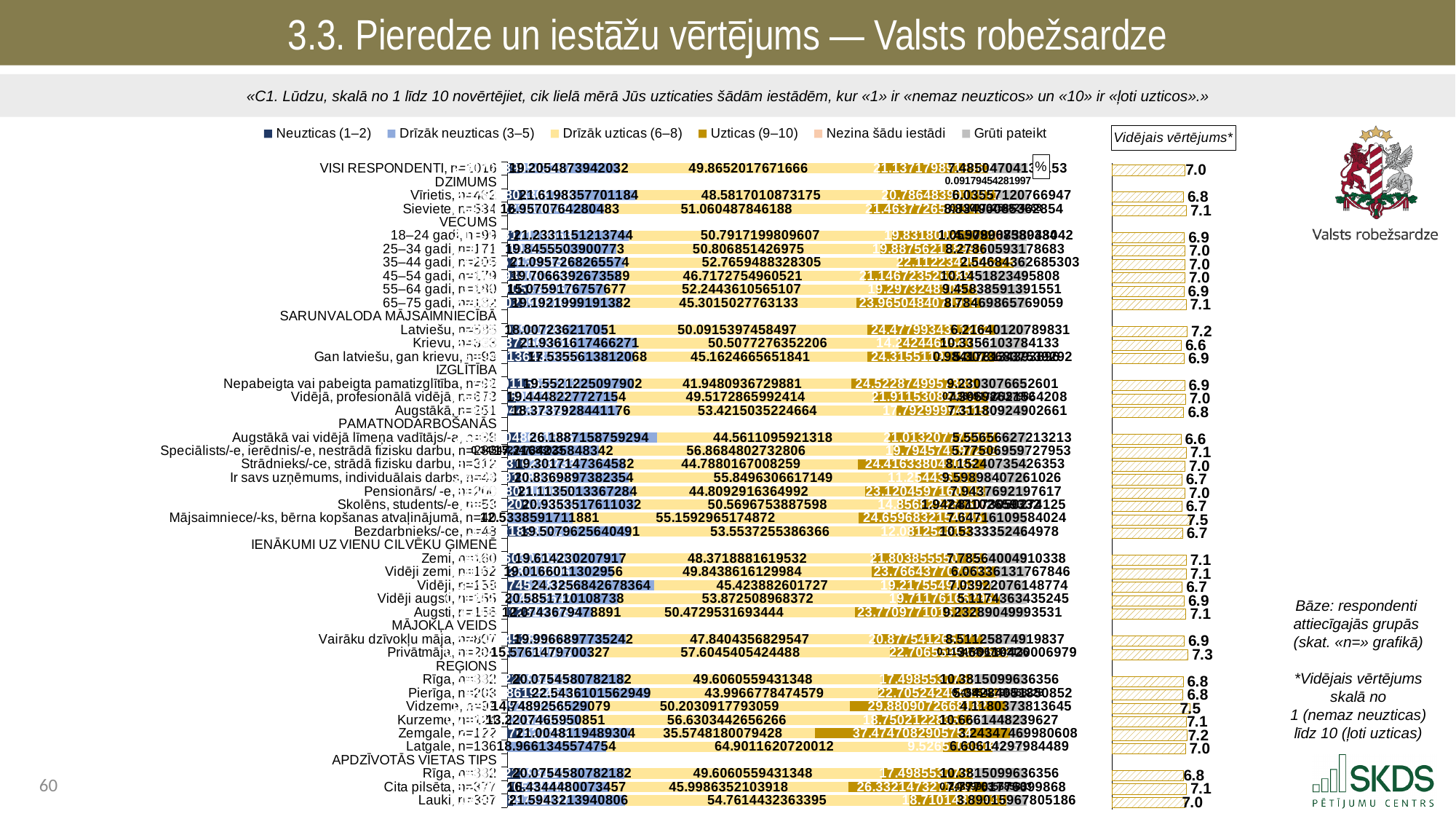
In the 'Vidējais vērtējums*' chart on the right, which group under SARUNVALODA MĀJSAIMNIECĪBĀ has the lowest average rating? Krievu In the main stacked chart, what is the 'Drīzāk uzticas (6–8)' value for 'Latgale, n=136'? 64.9011620720012 In the 'Vidējais vērtējums*' chart on the right, what is the average rating for 'Mājsaimniece/-ks, bērna kopšanas atvaļinājumā'? 7.5 In the 'Vidējais vērtējums*' chart on the right, what is the difference between the average ratings for 'Latviešu' and 'Krievu'? 0.6 In the main stacked chart, which region under REĢIONS has the highest 'Drīzāk uzticas (6–8)' value? Latgale In the 'Vidējais vērtējums*' chart on the right, what is the average rating for 'VISI RESPONDENTI, n=1016'? 7.0 What kind of chart is the main chart on the slide? Stacked bar chart In the 'Vidējais vērtējums*' chart on the right, which has a higher average rating: 'Privātmāja' or 'Vairāku dzīvokļu māja'? Privātmāja In the 'Vidējais vērtējums*' chart on the right, what is the average rating for 'Latviešu'? 7.2 How many series does the legend of the main stacked chart list? 6 In the 'Vidējais vērtējums*' chart on the right, which region under REĢIONS has the highest average rating? Vidzeme In the 'Vidējais vērtējums*' chart on the right, what is the average rating for 'Krievu'? 6.6